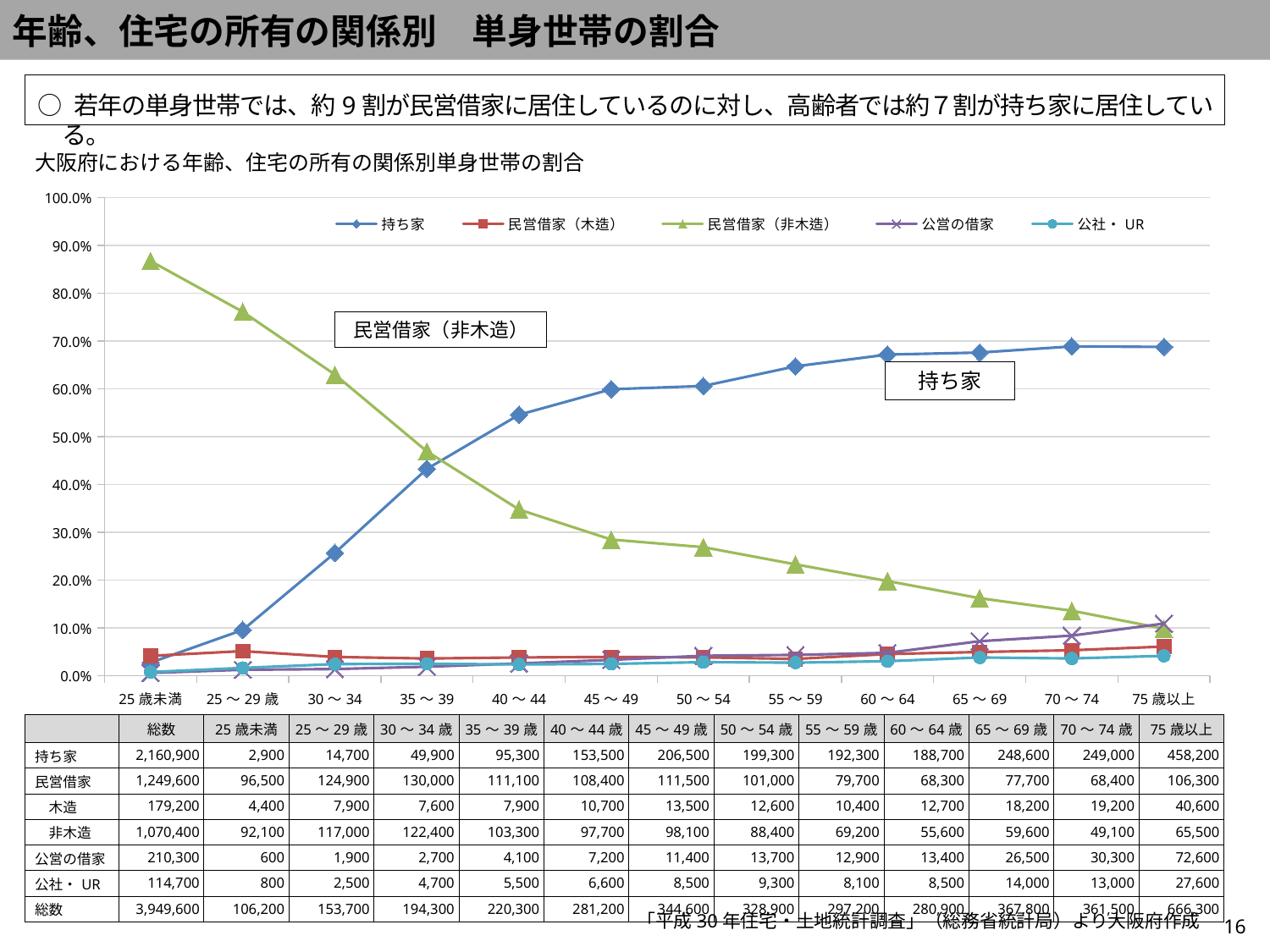
For which age category is the 民営借家（非木造） value highest? 25歳未満 How many series does the chart legend list? 5 For which age category is the 持ち家 value lowest? 25歳未満 Does the 民営借家（非木造） series rise or fall as age increases along the x axis? fall Does the 持ち家 series rise or fall as age increases along the x axis? rise Is the 持ち家 value for 25歳未満 greater or less than 10.0%? less At 30～34, which is larger: 持ち家 or 民営借家（非木造）? 民営借家（非木造） What is the title printed above the chart? 大阪府における年齢、住宅の所有の関係別単身世帯の割合 Is the 民営借家（非木造） value for 25歳未満 greater or less than 80.0%? greater What kind of chart is shown on the slide? line chart Is the 持ち家 value for 75歳以上 greater or less than 60.0%? greater How many age categories are plotted along the x axis? 12